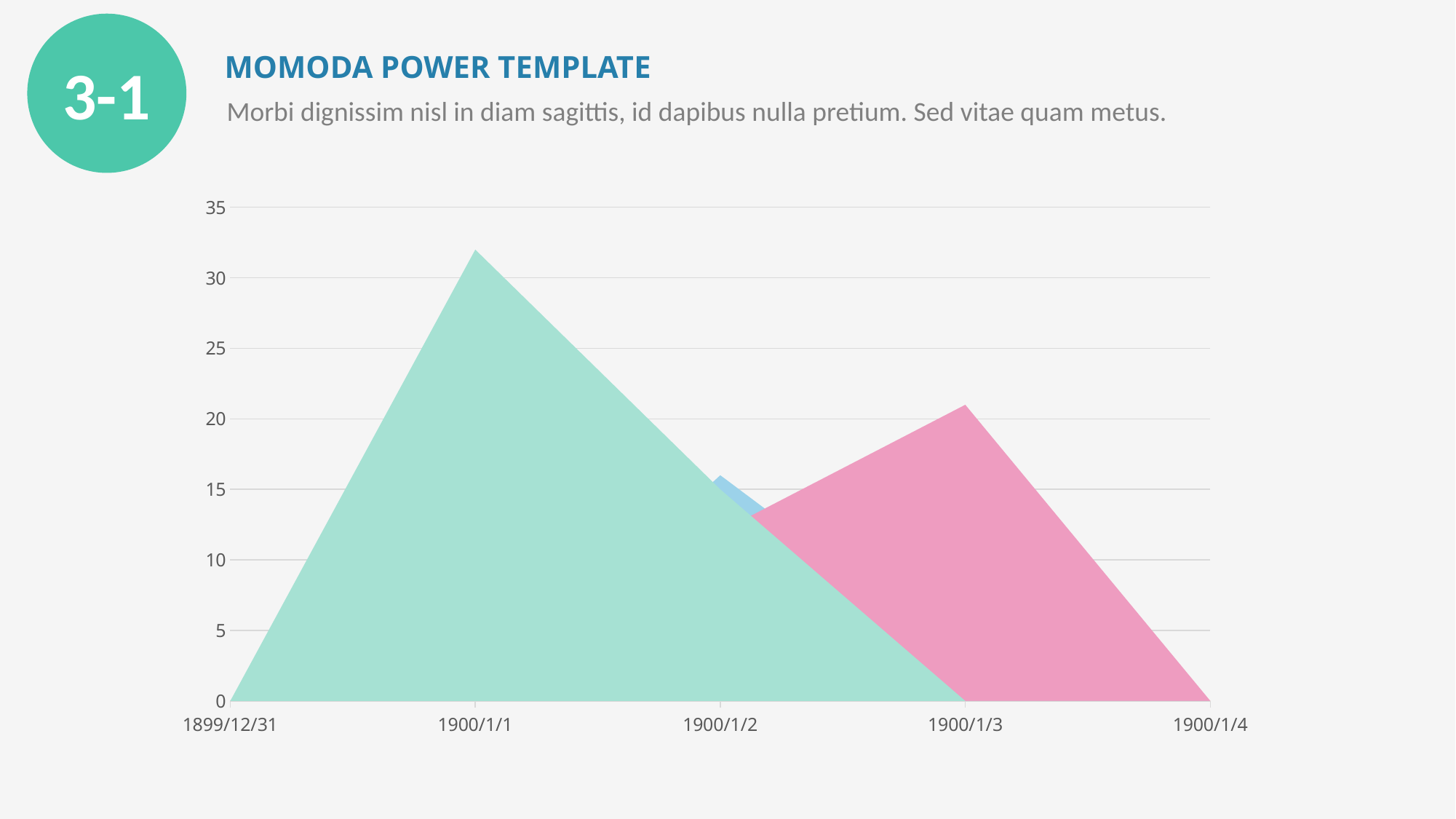
Which is larger: the peak of the green series at 1900/1/1 or the peak of the pink series at 1900/1/3? the green series peak at 1900/1/1 Is the value of the green series at 1900/1/2 greater or less than 20? less Is the value of the green series at 1900/1/1 greater or less than 30? greater What is the highest value shown on the y axis of the chart? 35 How many dates are labelled along the x axis of the chart? 5 At which date does the pink area series reach its highest value? 1900/1/3 At which date does the green area series reach its highest value? 1900/1/1 What kind of chart is shown on the slide? area chart How many coloured area series are plotted on the chart? 3 Does the green series rise or fall from 1900/1/1 to 1900/1/3? fall Is the value of the pink series at 1900/1/3 greater or less than 15? greater